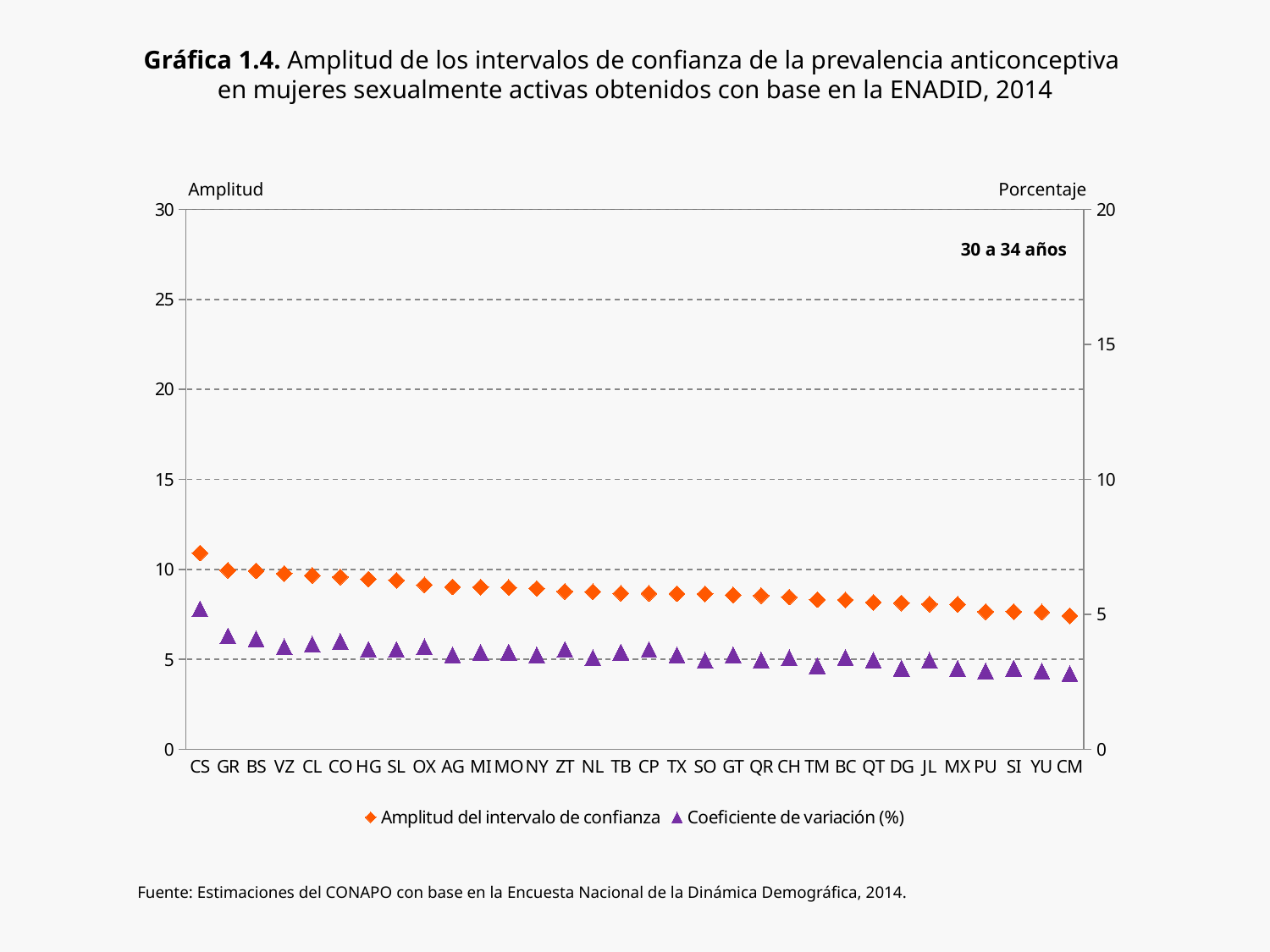
What kind of chart is shown on the slide? Scatter chart Which state has the highest value for Amplitud del intervalo de confianza? CS What is the label of the right-hand vertical axis? Porcentaje How many states (categories) are plotted along the x axis? 32 Is the Amplitud del intervalo de confianza for CM greater or less than 10? less Which age group does the chart refer to, according to the label inside the plot area? 30 a 34 años Which is larger, the Amplitud del intervalo de confianza for CS or for GR? CS Is the Coeficiente de variación (%) for CM greater or less than 5 on the right axis? less Do the values of Amplitud del intervalo de confianza rise or fall from left to right along the x axis? Fall Is the Amplitud del intervalo de confianza for CS greater or less than 10? greater How many series does the legend list? 2